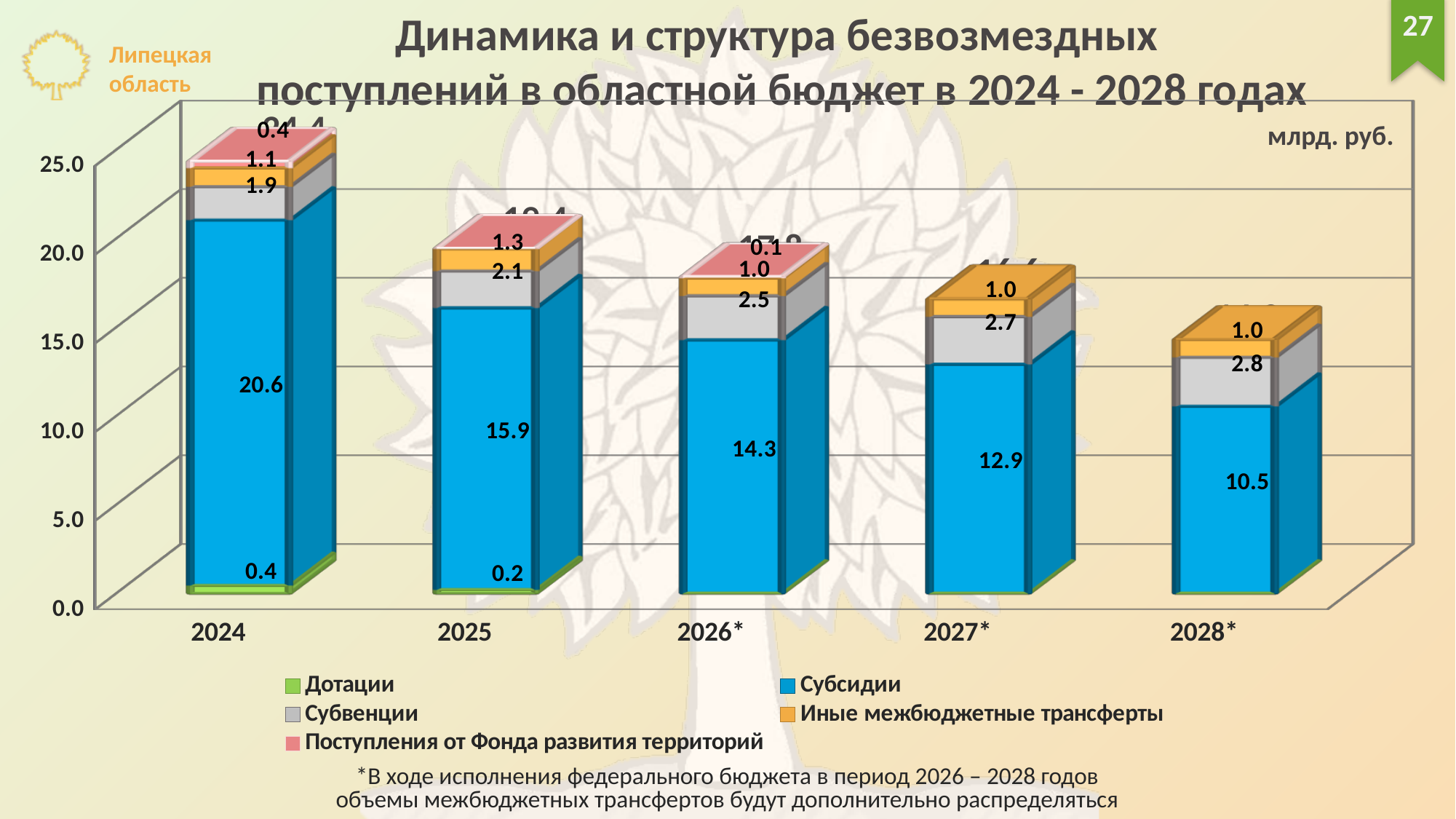
What is the value of Поступления от Фонда развития территорий for 2026*? 0.1 How many years are shown on the x axis? 5 Which is larger, the Субвенции value for 2024 or for 2027*? 2027* What is the value of Дотации for 2025? 0.2 How does the value of Субсидии change from 2024 to 2028*? It falls Which year has the lowest value of Субсидии? 2028* Which year has the highest value of Субсидии? 2024 What is the difference between the Субсидии values for 2024 and 2028*? 10.1 What is the value of Субвенции for 2028*? 2.8 How many series does the legend list? 5 What is the value of Субсидии for 2024? 20.6 What is the value of Иные межбюджетные трансферты for 2025? 1.3